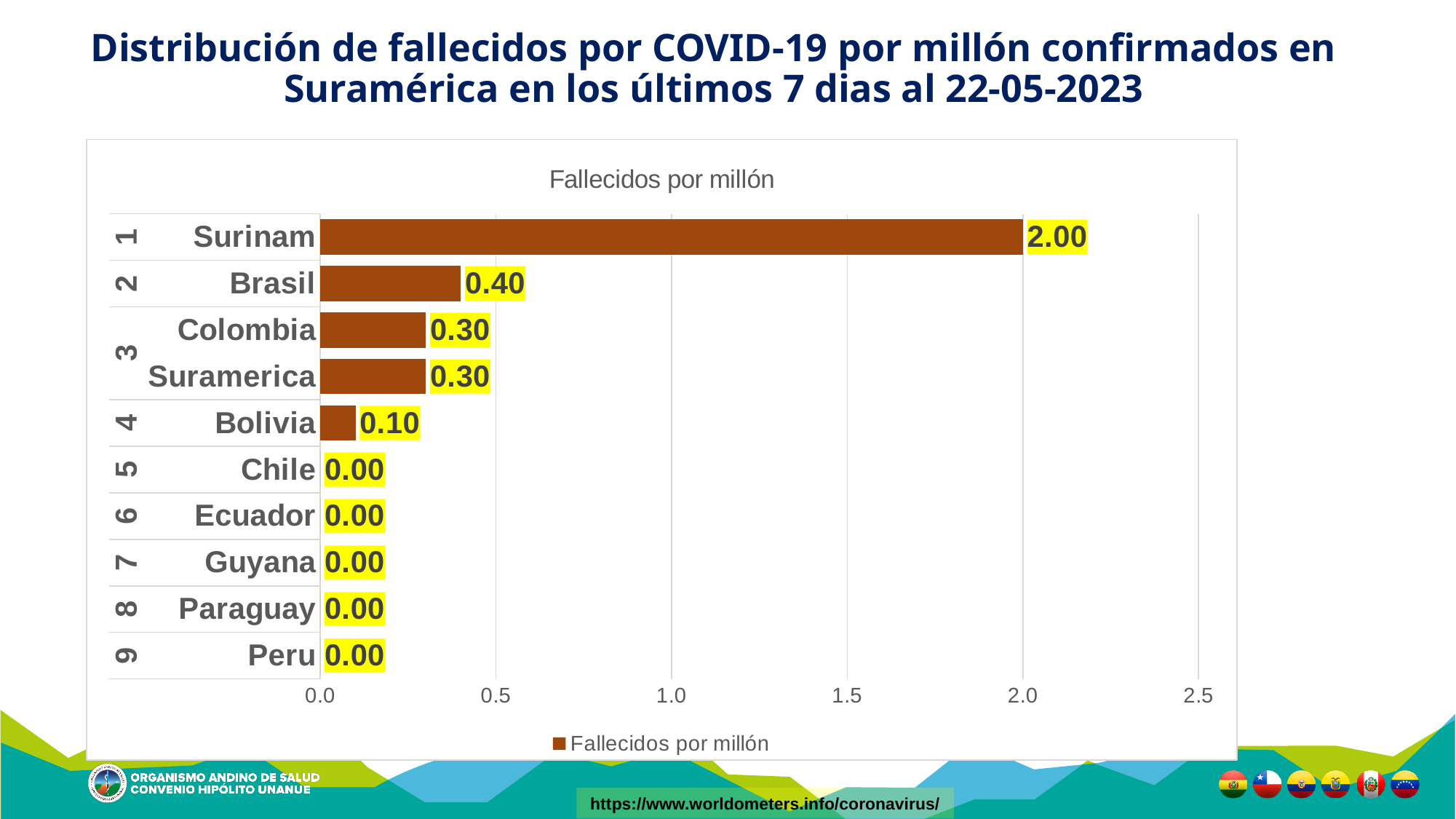
Is the value for Surinam greater or less than 1.5? greater What is the value for Suramerica? 0.30 What kind of chart is shown on the slide? bar chart What is the value for Surinam? 2.00 What is the legend entry shown below the chart? Fallecidos por millón What is the value for Brasil? 0.40 How many categories are shown on the chart? 10 What is the value for Bolivia? 0.10 What is the difference between the values for Colombia and Bolivia? 0.20 Which is larger, the value for Brasil or the value for Colombia? Brasil Which category has the highest value? Surinam What is the difference between the values for Surinam and Brasil? 1.60